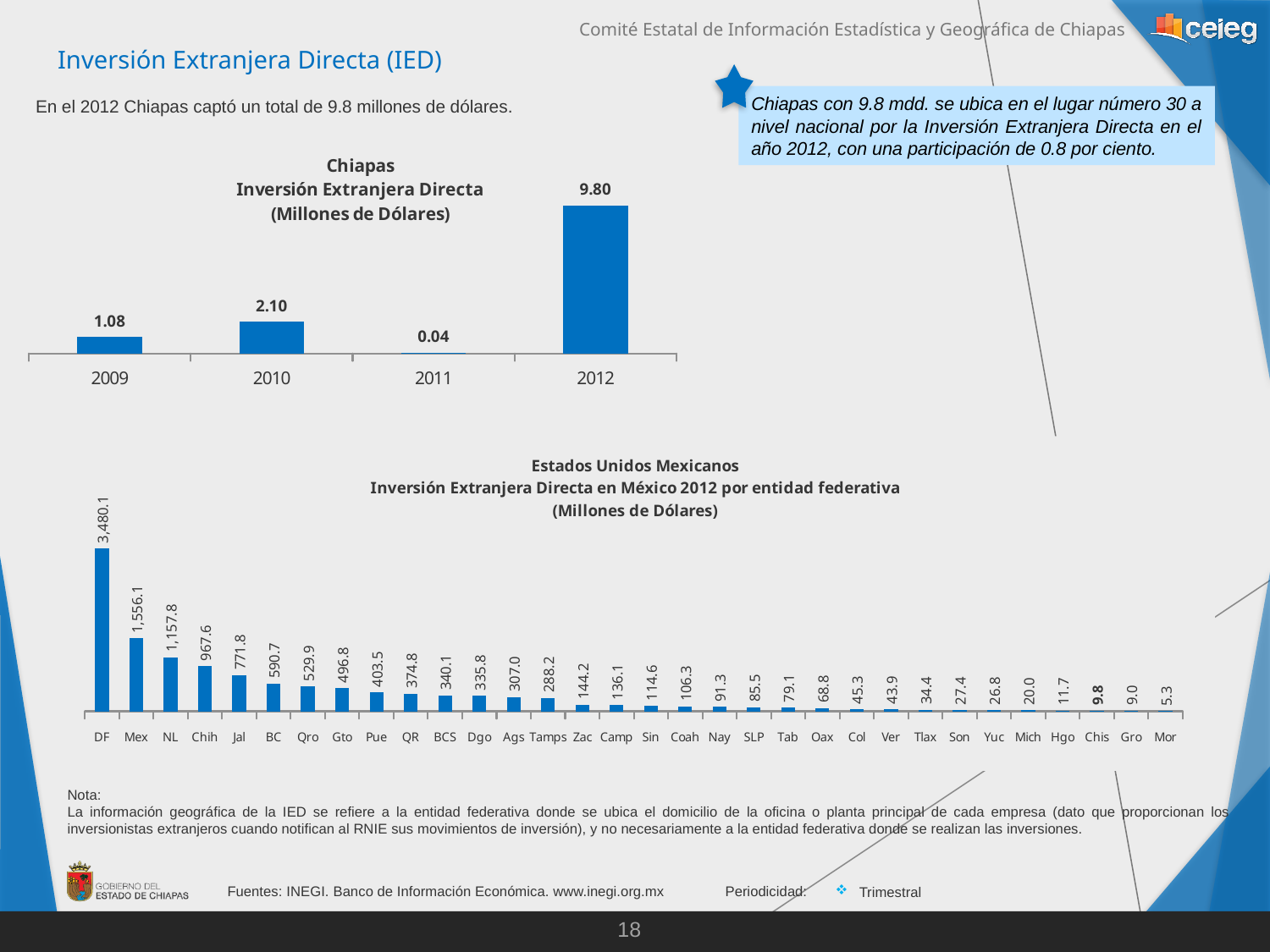
In the Chiapas Inversión Extranjera Directa chart, what is the value for 2012? 9.80 In the Estados Unidos Mexicanos chart, how many entities are shown? 32 In the Chiapas Inversión Extranjera Directa chart, which year has the lowest value? 2011 In the Chiapas Inversión Extranjera Directa chart, how many years are shown? 4 In the Estados Unidos Mexicanos chart, which entity has the lowest value? Mor In the Estados Unidos Mexicanos chart, what is the value for Chis? 9.8 In the Chiapas Inversión Extranjera Directa chart, what is the difference between the 2012 and 2010 values? 7.70 In the Chiapas Inversión Extranjera Directa chart, what is the value for 2011? 0.04 In the Estados Unidos Mexicanos chart, what is the difference between the values for Mex and NL? 398.3 In the Estados Unidos Mexicanos chart, what is the value for DF? 3,480.1 What kind of chart is the Chiapas Inversión Extranjera Directa chart? Bar chart In the Estados Unidos Mexicanos chart, which is larger, the value for Jal or the value for BC? Jal